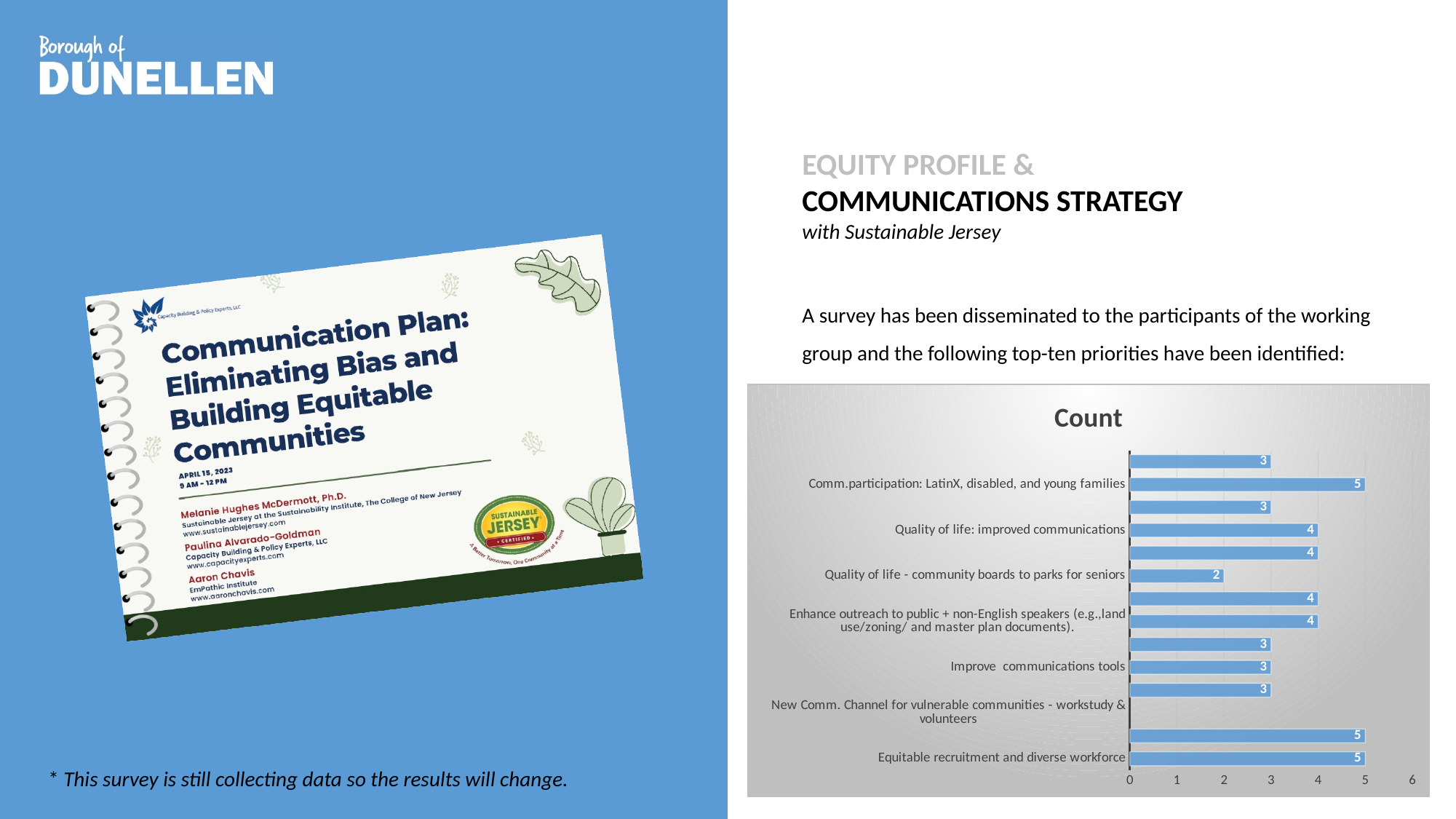
Which is larger: the value for "Quality of life: improved communications" or the value for "Improve communications tools"? Quality of life: improved communications What is the difference between the values for "Comm.participation: LatinX, disabled, and young families" and "Quality of life - community boards to parks for seniors"? 3 What type of chart is shown on the slide? bar chart What is the value for "Comm.participation: LatinX, disabled, and young families"? 5 What is the highest value shown on the x axis? 6 What is the title of the chart? Count Which labeled category has the lowest value? Quality of life - community boards to parks for seniors What is the value for "Equitable recruitment and diverse workforce"? 5 What is the value for "Quality of life - community boards to parks for seniors"? 2 Is the value for "Equitable recruitment and diverse workforce" greater or less than 4? greater What is the value for "Improve communications tools"? 3 What is the value for "Quality of life: improved communications"? 4